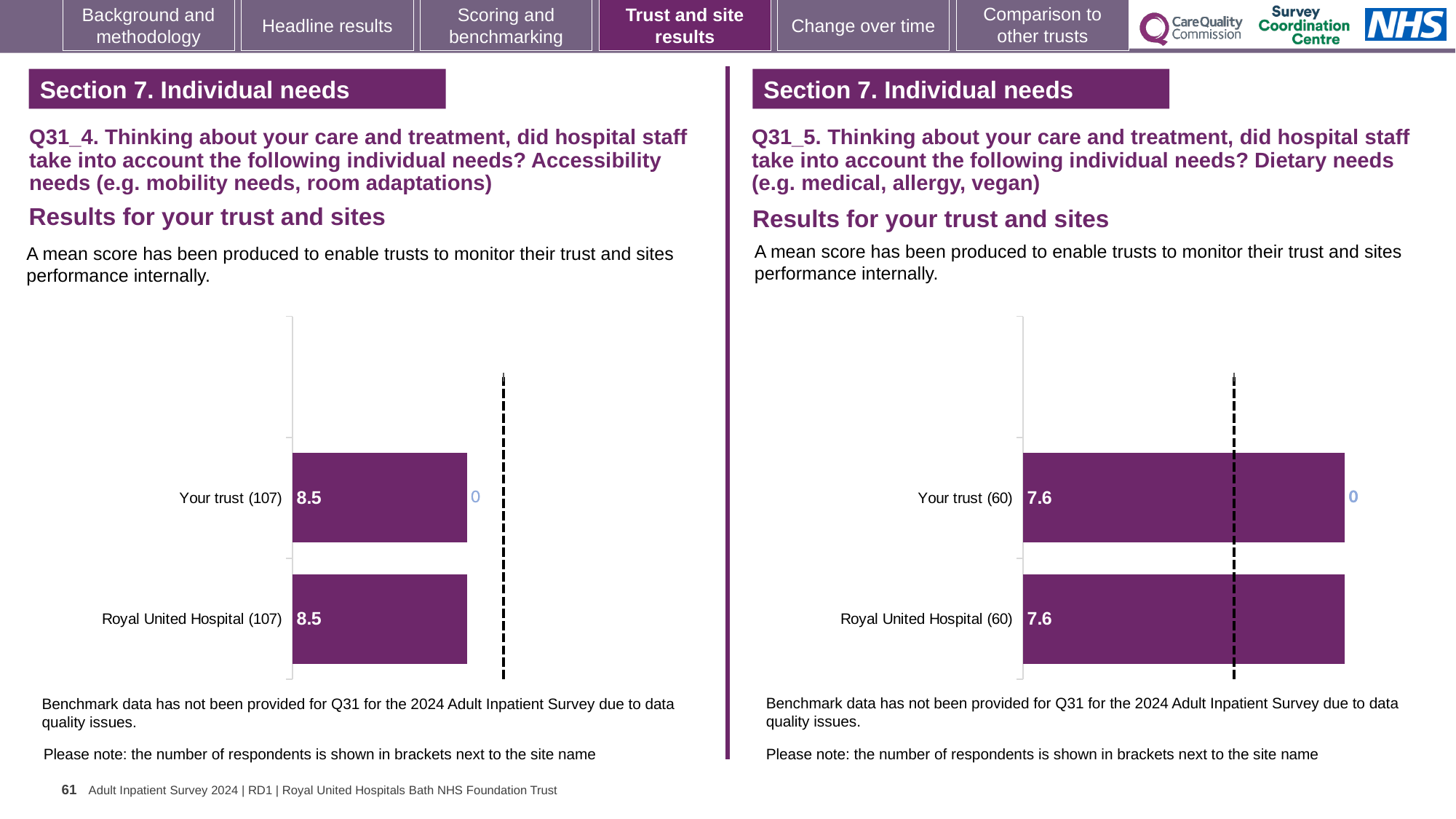
In the Q31_5 chart (right), what is the difference between the scores for Your trust and Royal United Hospital? 0 In the Q31_5 chart (right), what is the mean score for Royal United Hospital (60)? 7.6 In the Q31_4 chart (left), how many respondents are shown in brackets next to Royal United Hospital? 107 In the Q31_4 chart (left), what is the mean score for Your trust (107)? 8.5 In the Q31_4 chart (left), what is the mean score for Royal United Hospital (107)? 8.5 How many bars are plotted in the Q31_4 chart (left)? 2 How many bars are plotted in the Q31_5 chart (right)? 2 In the Q31_5 chart (right), how many respondents are shown in brackets next to Your trust? 60 In the Q31_5 chart (right), what is the mean score for Your trust (60)? 7.6 Is the Your trust score in the Q31_4 chart (left) larger than the Your trust score in the Q31_5 chart (right)? Yes What type of chart is used for the Q31_5 results (right)? Bar chart In the Q31_4 chart (left), what is the difference between the scores for Your trust and Royal United Hospital? 0